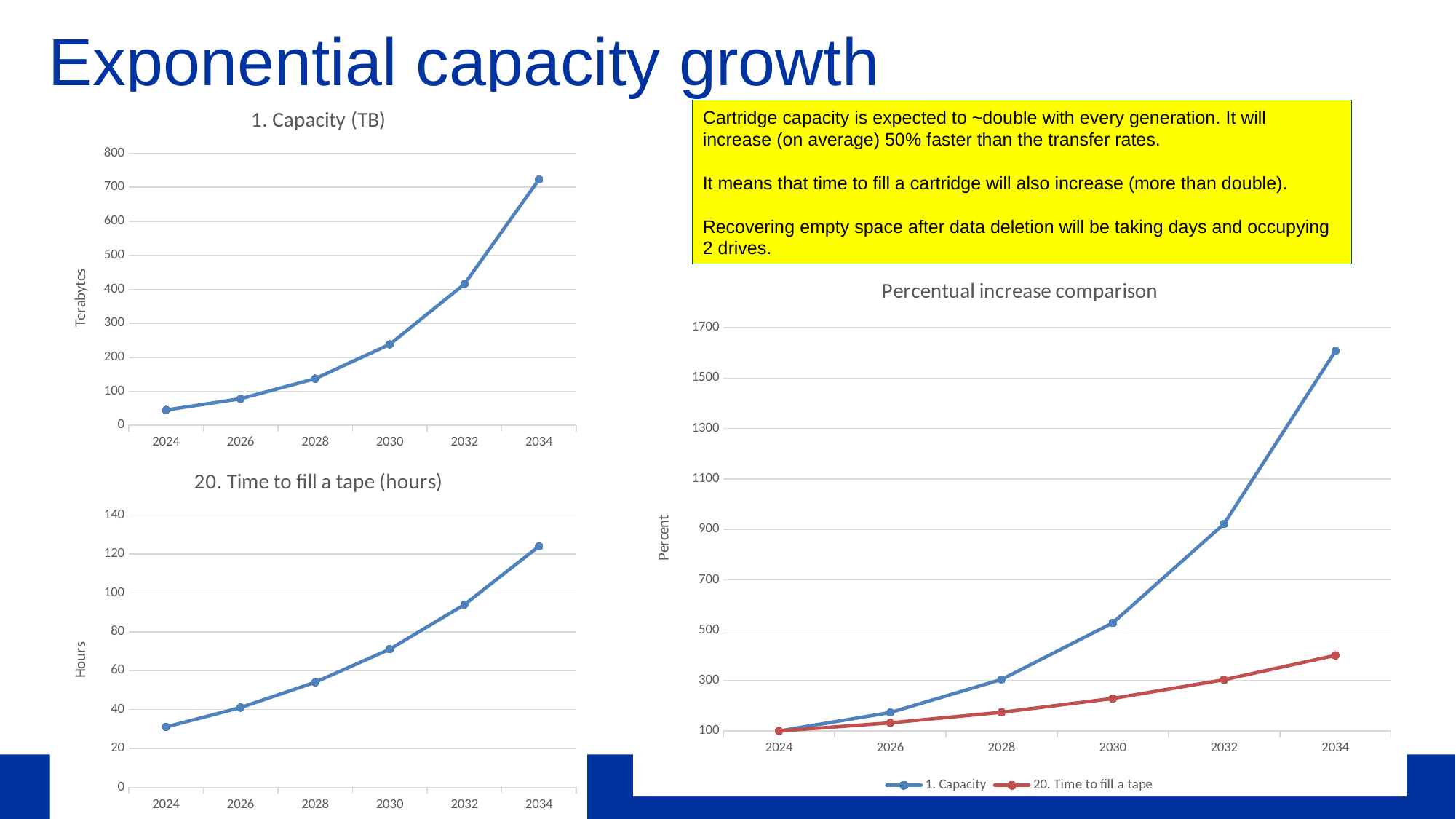
In the 'Percentual increase comparison' chart, how many series does the legend list? 2 In the '20. Time to fill a tape (hours)' chart, which year has the lowest value? 2024 In the '1. Capacity (TB)' chart, which year has the highest capacity? 2034 In the '1. Capacity (TB)' chart, is the value for 2034 greater or less than 700? greater In the 'Percentual increase comparison' chart, do the values rise or fall from 2024 to 2034? rise In the '20. Time to fill a tape (hours)' chart, is the value for 2032 greater or less than 100? less What kind of chart is '20. Time to fill a tape (hours)'? line chart In the '1. Capacity (TB)' chart, is the value for 2024 greater or less than 100? less How many data points are plotted in the '1. Capacity (TB)' chart? 6 In the 'Percentual increase comparison' chart, which series is higher in 2034, '1. Capacity' or '20. Time to fill a tape'? 1. Capacity